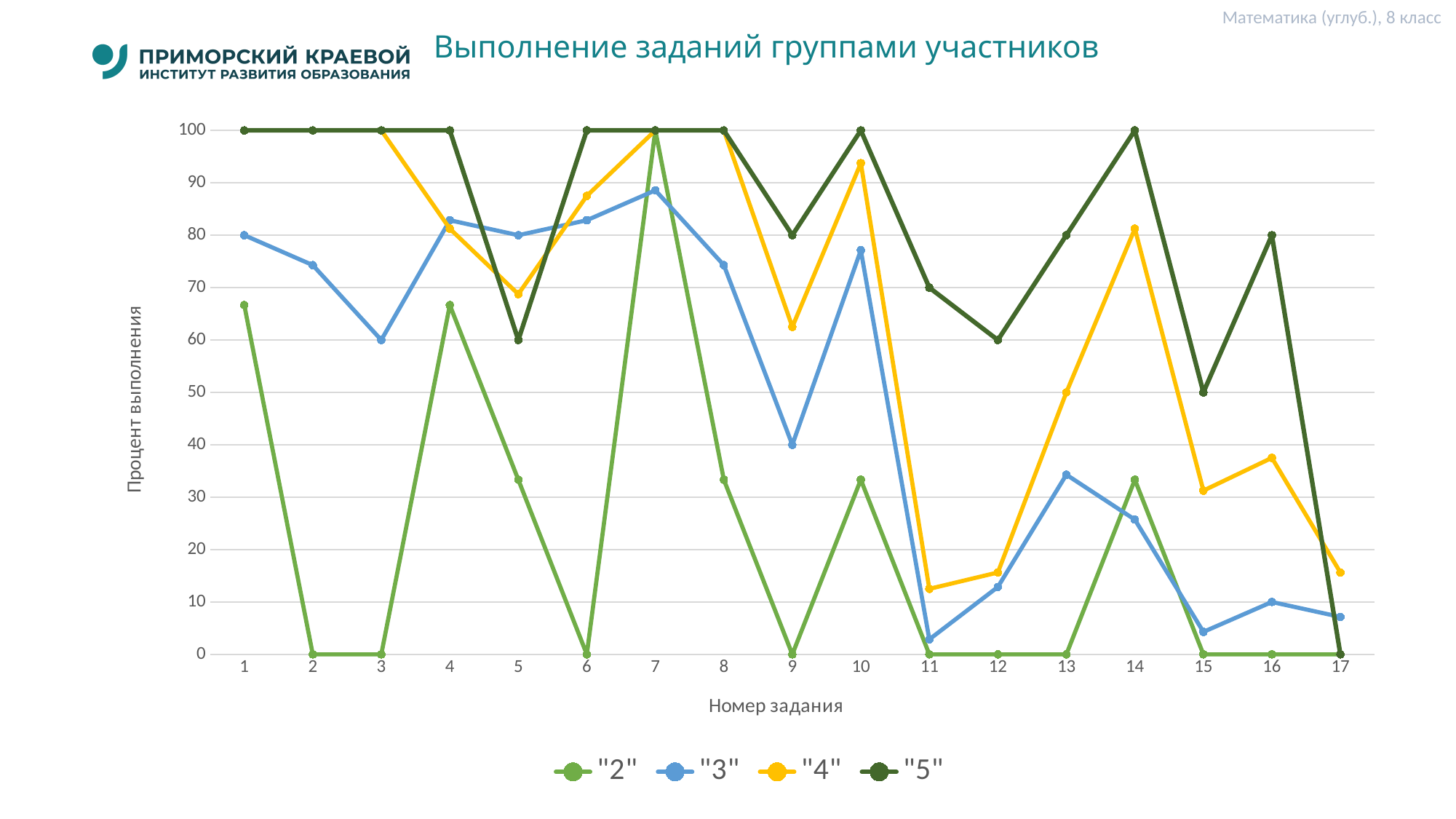
Is the value for series "4" at task 11 greater or less than 20? less Is the value for series "3" at task 7 greater or less than 80? greater What is the difference between series "5" and series "3" at task 9? 40 What is the value for series "5" at task 17? 0 How many task numbers are shown on the x axis? 17 What is the value for series "3" at task 9? 40 What is the value for series "2" at task 2? 0 What is the value for series "5" at task 5? 60 What kind of chart is shown on the slide? line chart How many series does the legend list? 4 What is the value for series "4" at task 13? 50 Which series has the higher value at task 9, "4" or "3"? "4"